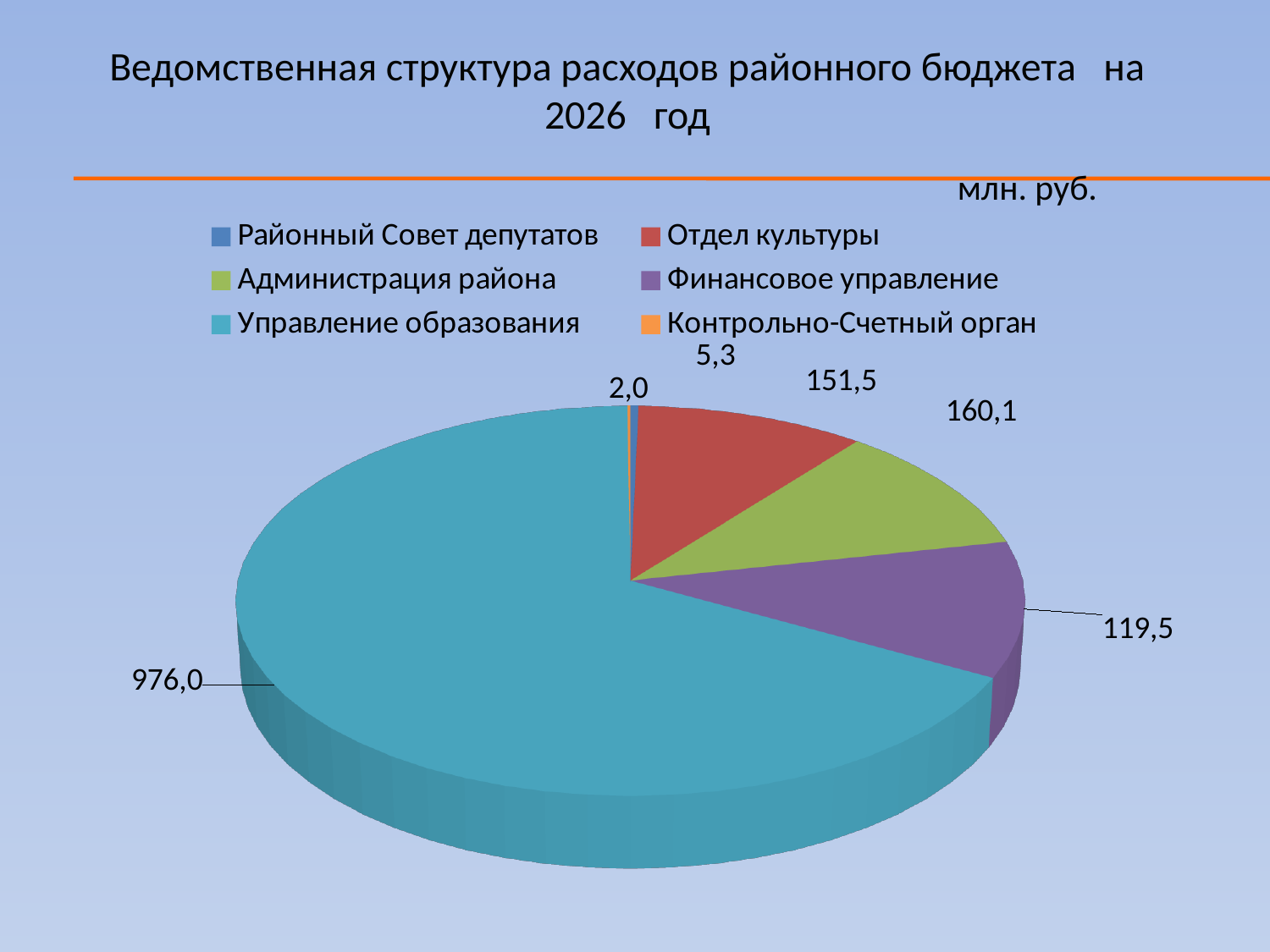
Which is larger, the value for Администрация района or the value for Отдел культуры? Администрация района What kind of chart is shown on the slide? pie chart What is the value for Финансовое управление? 119,5 What is the value for Отдел культуры? 151,5 What is the value for Управление образования? 976,0 Which category has the largest slice of the pie? Управление образования What unit is indicated for the values on the chart? млн. руб. What is the difference between the values for Управление образования and Финансовое управление? 856,5 What is the difference between the values for Администрация района and Отдел культуры? 8,6 What is the value for Администрация района? 160,1 How many categories does the legend list? 6 What colour is the slice for Финансовое управление? purple